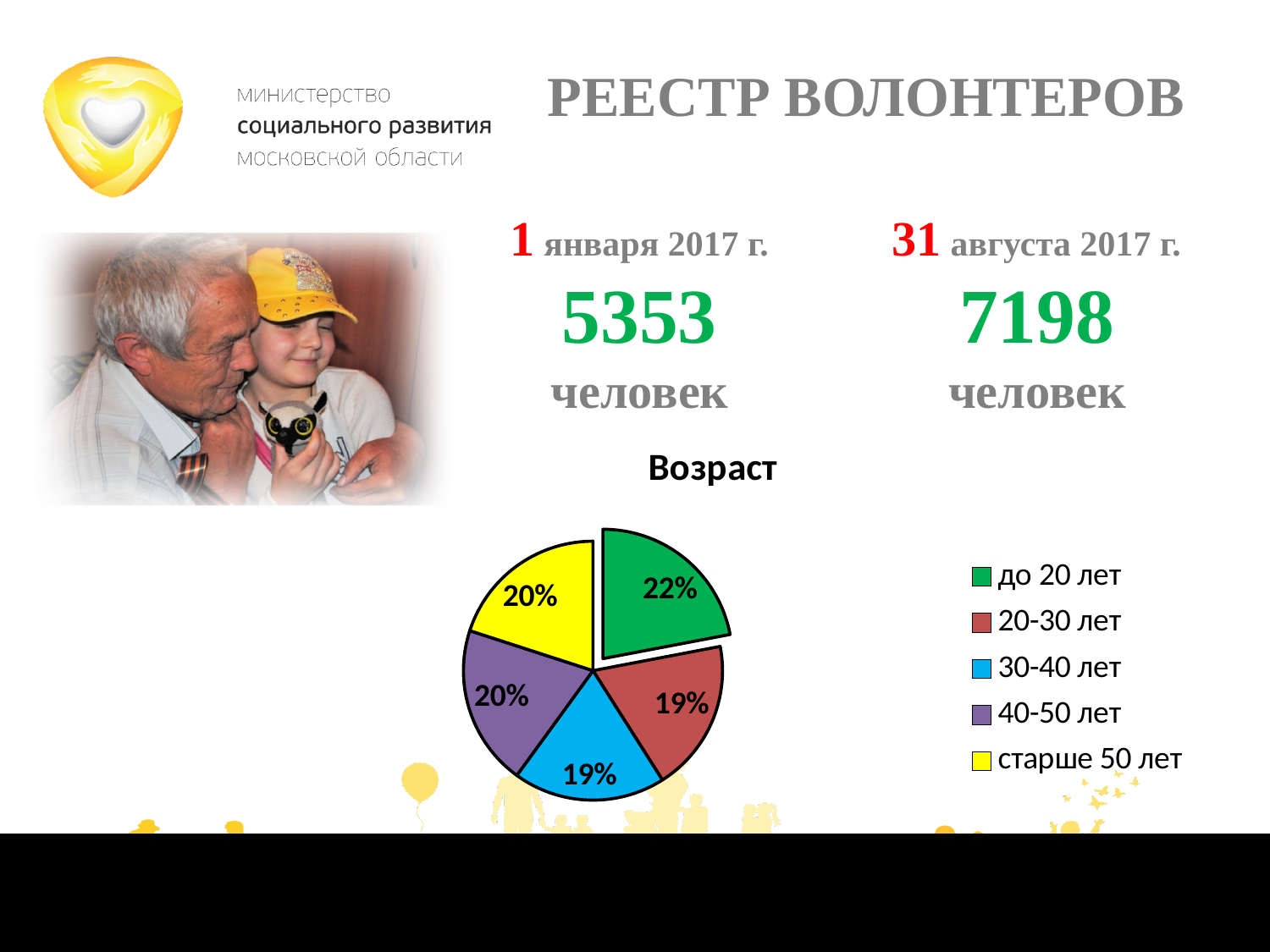
What is the share of the "30-40 лет" slice in the "Возраст" pie chart? 19% What colour is the "старше 50 лет" slice in the "Возраст" pie chart? yellow What kind of chart is shown under the heading "Возраст"? pie chart What is the share of the "40-50 лет" slice in the "Возраст" pie chart? 20% In the "Возраст" pie chart, which slice is larger: "до 20 лет" or "20-30 лет"? до 20 лет What is the share of the "20-30 лет" slice in the "Возраст" pie chart? 19% In the "Возраст" pie chart, by how many percentage points does "до 20 лет" exceed "30-40 лет"? 3 What is the share of the "старше 50 лет" slice in the "Возраст" pie chart? 20% How many slices does the "Возраст" pie chart have? 5 Which age group has the largest slice in the "Возраст" pie chart? до 20 лет What is the title of the pie chart on the slide? Возраст What is the share of the "до 20 лет" slice in the "Возраст" pie chart? 22%